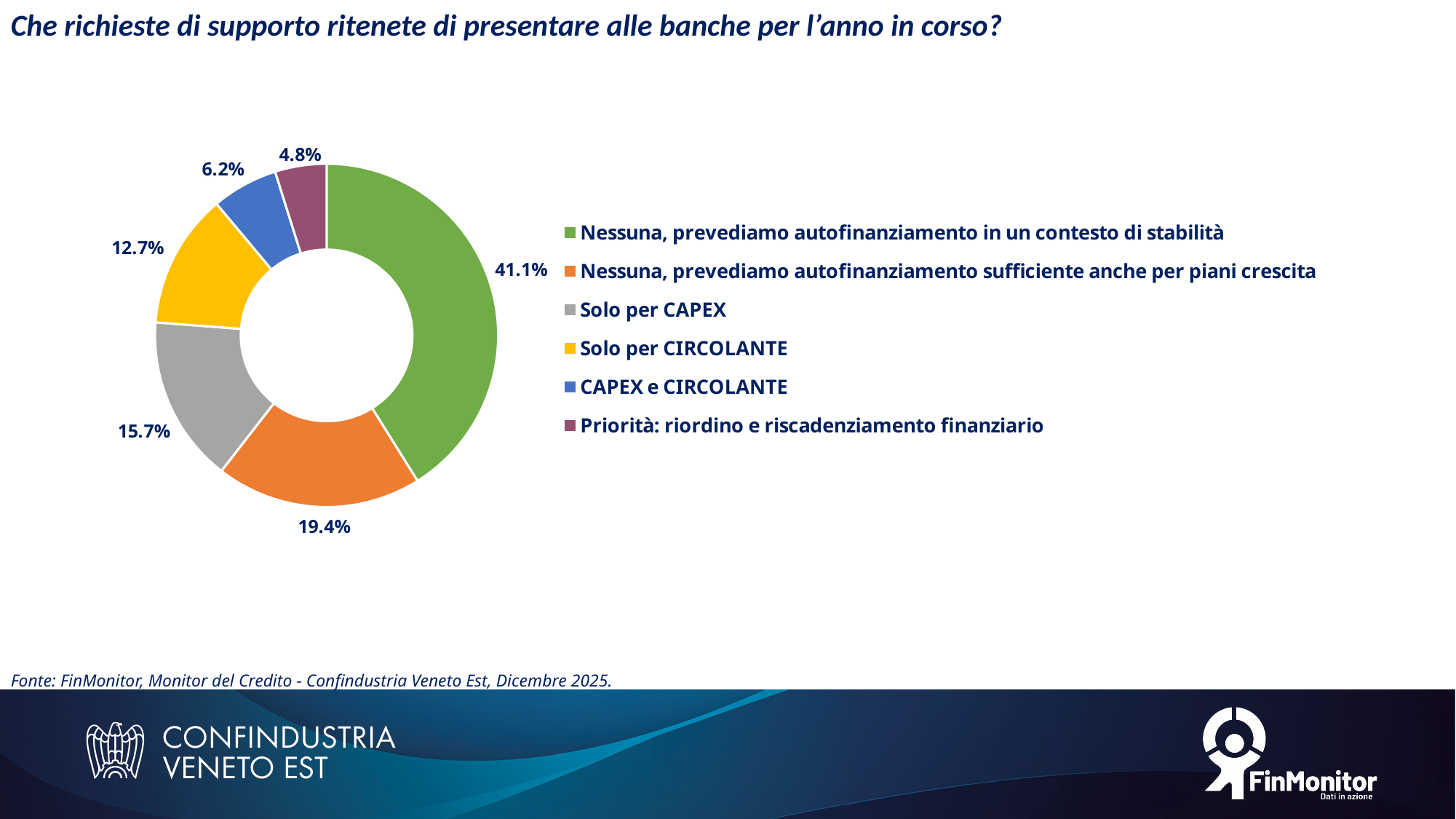
What share is shown for "Solo per CIRCOLANTE"? 12.7% What is the difference in percentage points between "Solo per CAPEX" and "Solo per CIRCOLANTE"? 3.0 How many categories are shown in the chart? 6 Which category has the largest share in the chart? Nessuna, prevediamo autofinanziamento in un contesto di stabilità What percentage of respondents chose "Solo per CAPEX"? 15.7% What value is shown for "Priorità: riordino e riscadenziamento finanziario"? 4.8% Which is larger: the share for "Solo per CAPEX" or for "CAPEX e CIRCOLANTE"? Solo per CAPEX Which category has the smallest share in the chart? Priorità: riordino e riscadenziamento finanziario What colour represents "Solo per CIRCOLANTE" in the chart? Yellow What type of chart is shown on the slide? Doughnut (pie) chart What percentage is shown for "Nessuna, prevediamo autofinanziamento sufficiente anche per piani crescita"? 19.4% What percentage corresponds to "CAPEX e CIRCOLANTE"? 6.2%